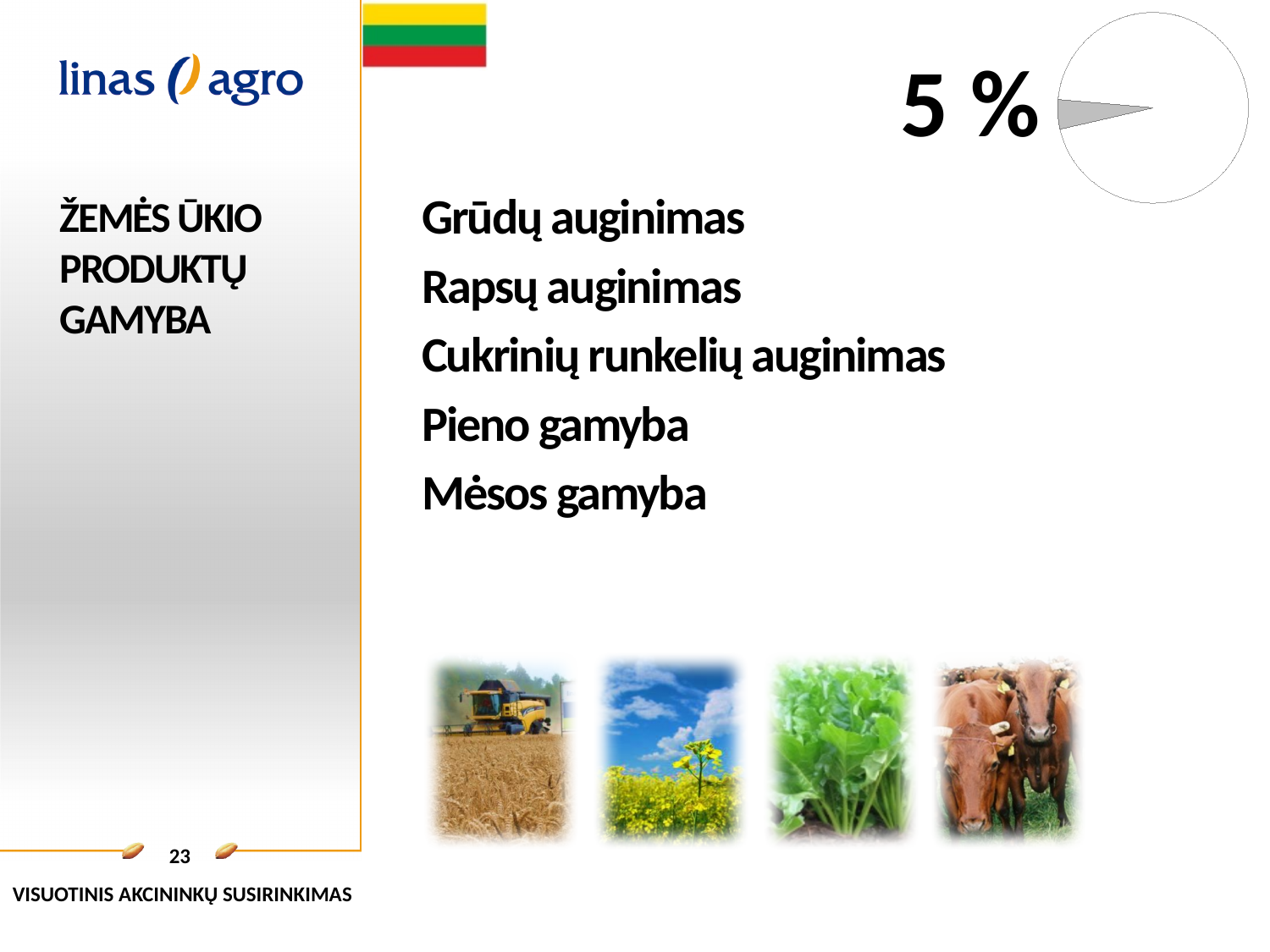
What colour is the highlighted slice of the pie chart? gray Does the pie chart have a legend? No Which slice of the pie chart is larger, the gray slice or the white slice? the white slice What percentage is printed next to the pie chart? 5 % What kind of chart is shown in the top right corner of the slide? pie chart How many slices does the pie chart have? 2 What share of the pie does the gray (highlighted) slice represent? 5 %